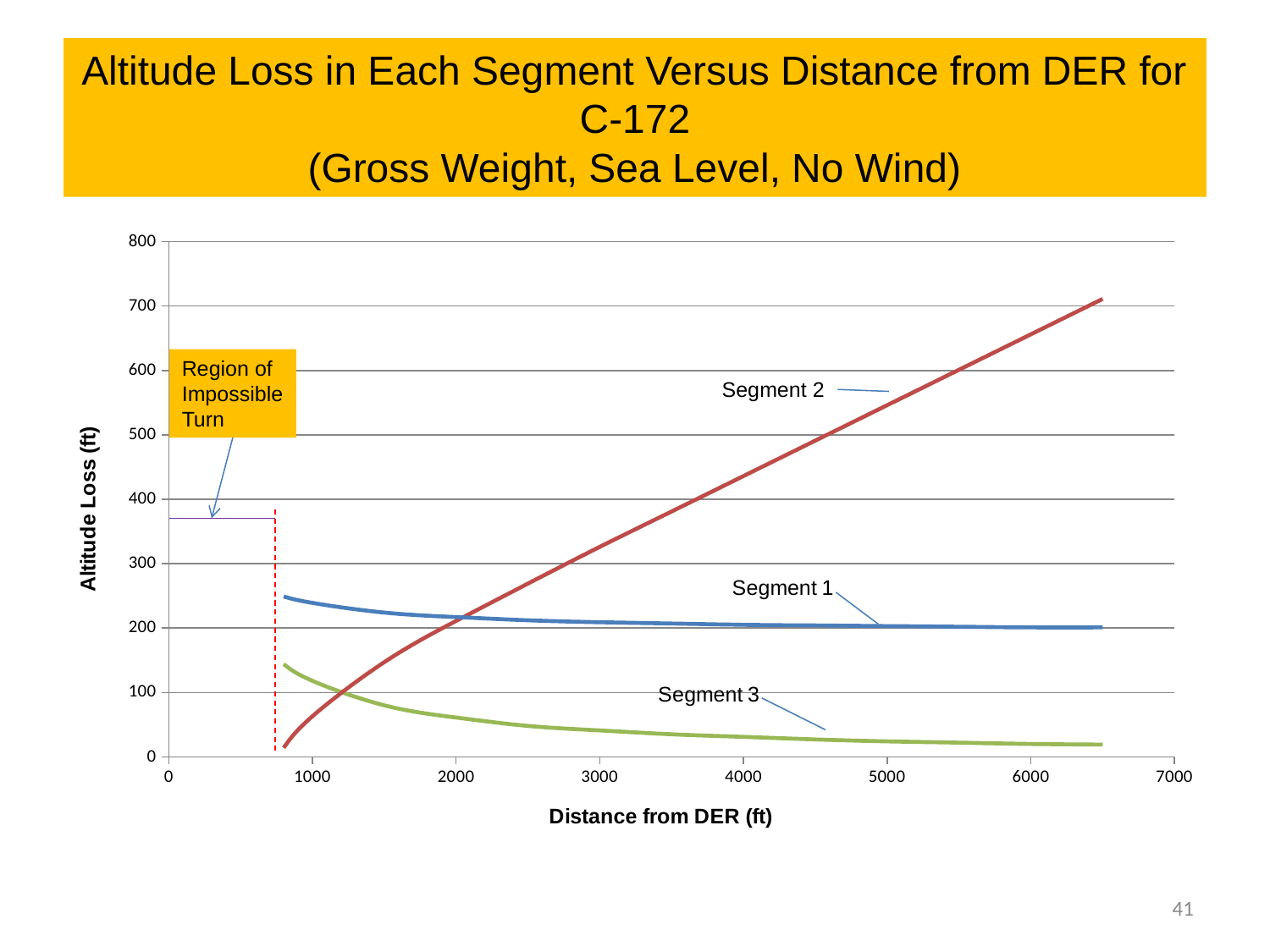
Does the altitude loss for Segment 3 rise or fall as distance from DER increases? Falls Does the altitude loss for Segment 2 rise or fall as distance from DER increases? Rises At a distance of 1000 ft from DER, which has the larger altitude loss, Segment 1 or Segment 2? Segment 1 Which segment has the highest altitude loss at a distance of 6000 ft from DER? Segment 2 What does the orange box at the left of the chart label? Region of Impossible Turn Which segment has the lowest altitude loss at a distance of 6000 ft from DER? Segment 3 How many segment curves are plotted on the chart? 3 What is the label of the x axis? Distance from DER (ft) What kind of chart is shown on the slide? Line chart Does the altitude loss for Segment 1 rise or fall as distance from DER increases? Falls Is the altitude loss for Segment 2 at 6000 ft from DER greater or less than 600? greater Is the altitude loss for Segment 3 at 6000 ft from DER greater or less than 100? less